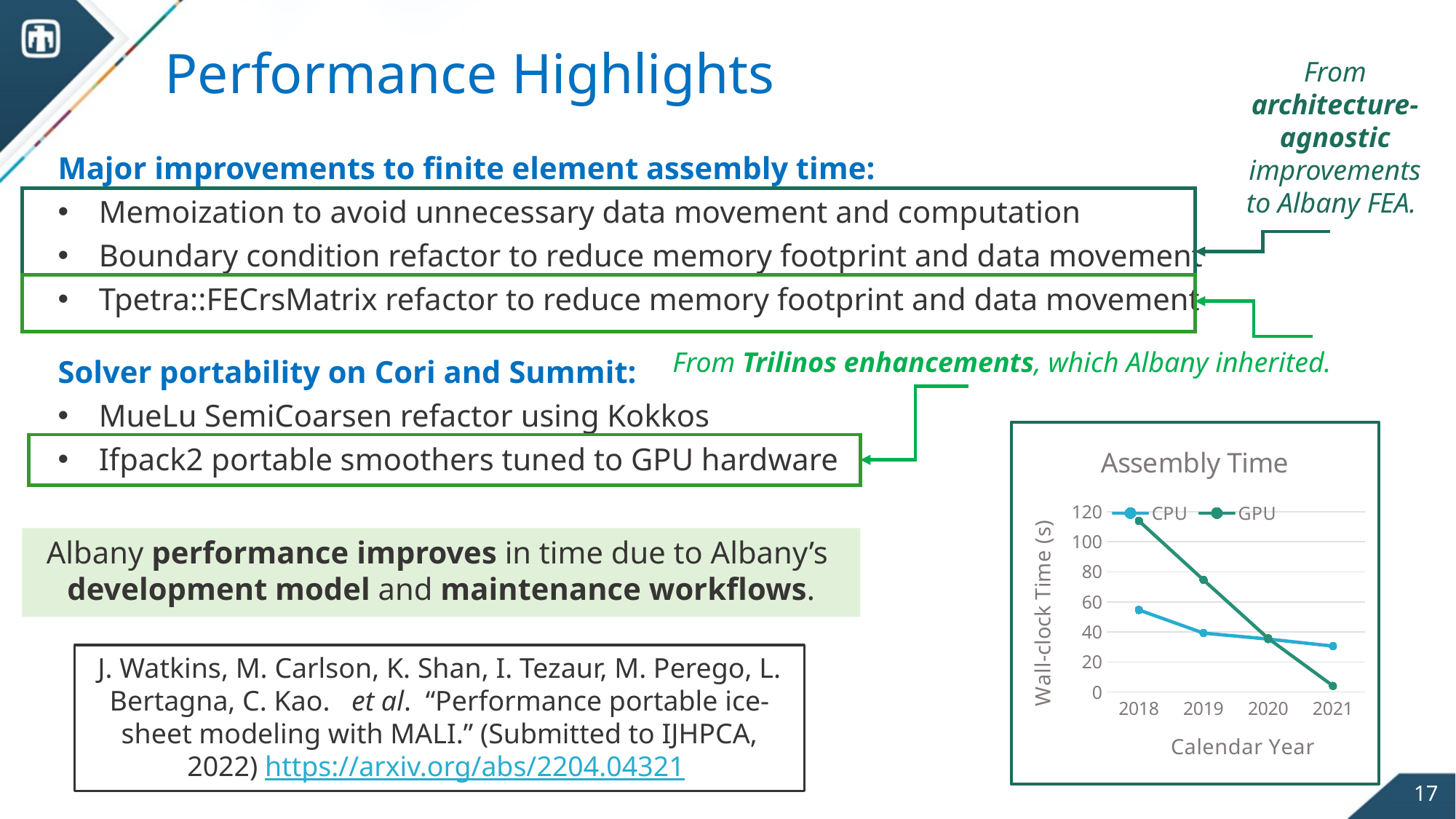
How many calendar years are plotted on the x axis of the Assembly Time chart? 4 What is the label of the y axis in the Assembly Time chart? Wall-clock Time (s) In the Assembly Time chart, does the CPU wall-clock time rise or fall from 2018 to 2021? fall In the Assembly Time chart, is the GPU value for 2021 greater or less than 20? less How many series does the legend of the Assembly Time chart list? 2 In the Assembly Time chart, which series has the larger value in 2018, CPU or GPU? GPU In the Assembly Time chart, does the GPU wall-clock time rise or fall from 2018 to 2021? fall In the Assembly Time chart, is the GPU value for 2018 greater or less than 100? greater What kind of chart is the Assembly Time chart? line chart In the Assembly Time chart, which series has the larger value in 2021, CPU or GPU? CPU In the Assembly Time chart, which year has the lowest GPU wall-clock time? 2021 In the Assembly Time chart, is the GPU value for 2019 greater or less than 60? greater